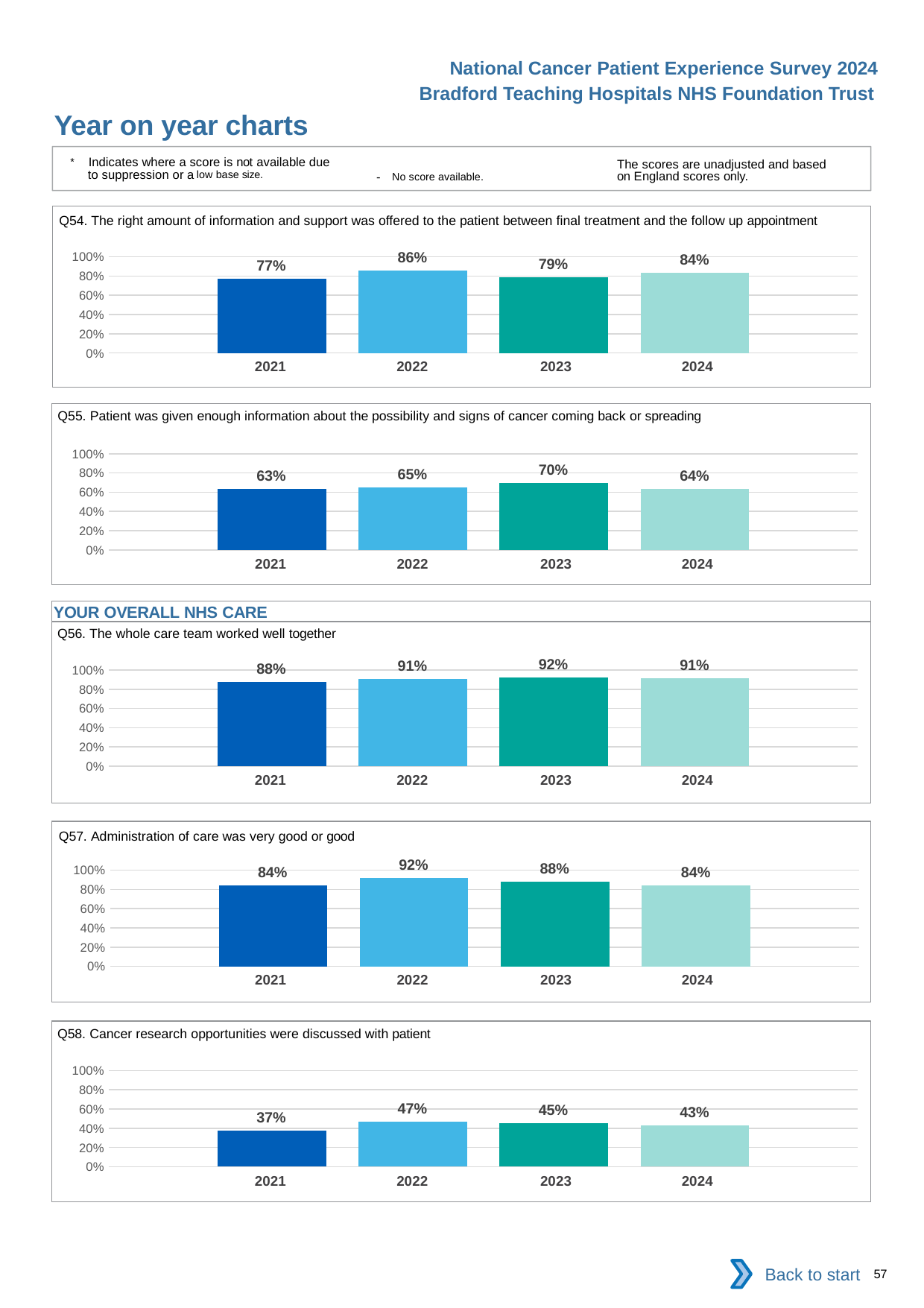
In the Q54 chart, what is the value for 2022? 86% In the Q56 chart, do the values rise or fall from 2021 to 2023? rise In the Q55 chart, what is the value for 2024? 64% In the Q57 chart, what is the difference between the 2022 and 2024 values? 8% In the Q58 chart, which is larger, the value for 2022 or the value for 2024? 2022 In the Q57 chart, what is the value for 2021? 84% How many years are shown in the Q54 chart? 4 What is the section heading shown above the Q56 chart? YOUR OVERALL NHS CARE In the Q58 chart, is the value for 2021 greater or less than 40%? less In the Q56 chart, which year has the lowest value? 2021 In the Q55 chart, which year has the highest value? 2023 What kind of chart is the Q55 chart? bar chart